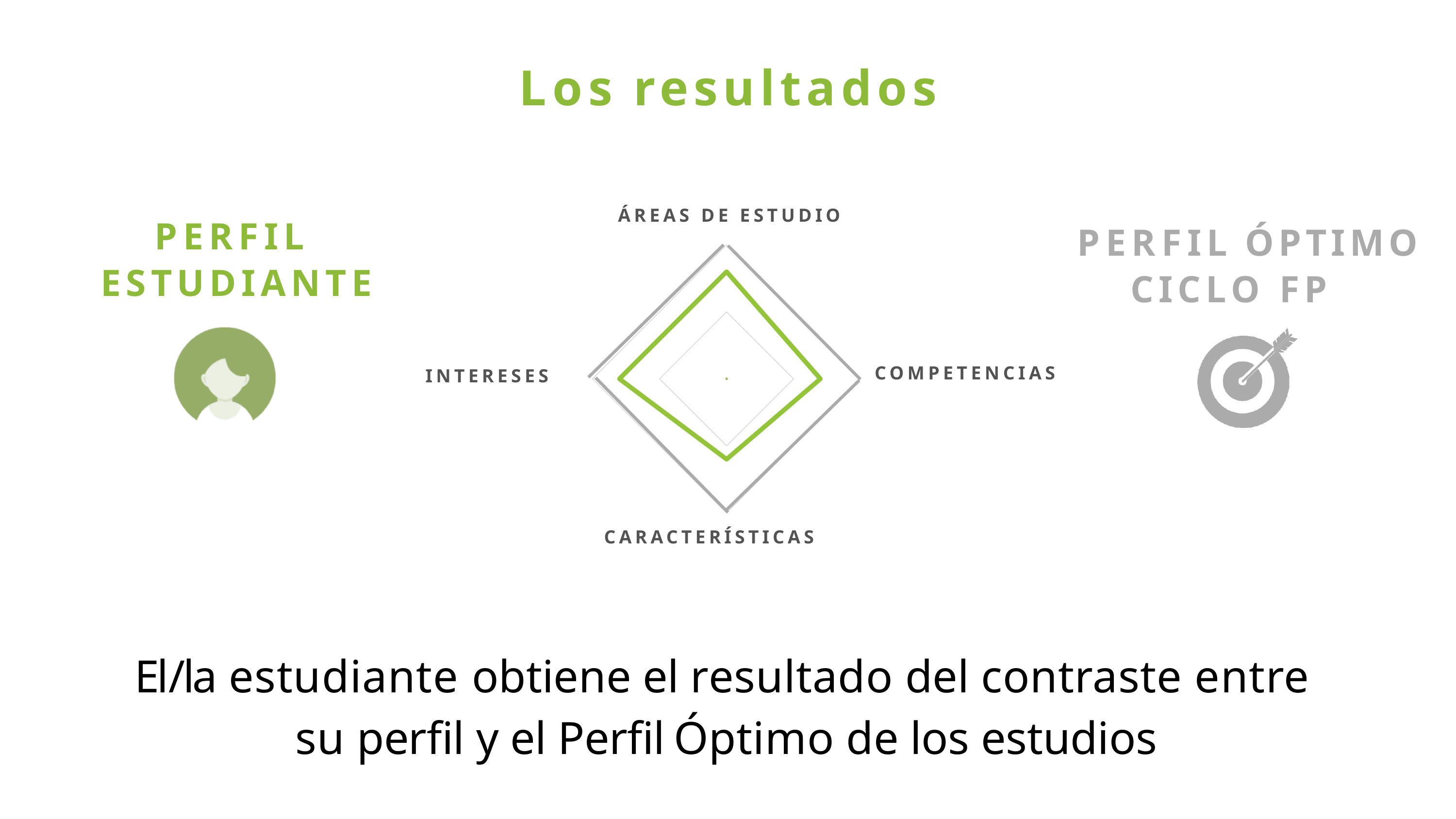
Which category label appears at the top of the radar chart? ÁREAS DE ESTUDIO How many axes (categories) does the radar chart have? 4 Which category label appears at the bottom of the radar chart? CARACTERÍSTICAS Which profile is plotted with the green line on the radar chart? Perfil Estudiante Which category label appears on the right side of the radar chart? COMPETENCIAS Which category label appears on the left side of the radar chart? INTERESES What kind of chart is shown in the centre of the slide? Radar chart